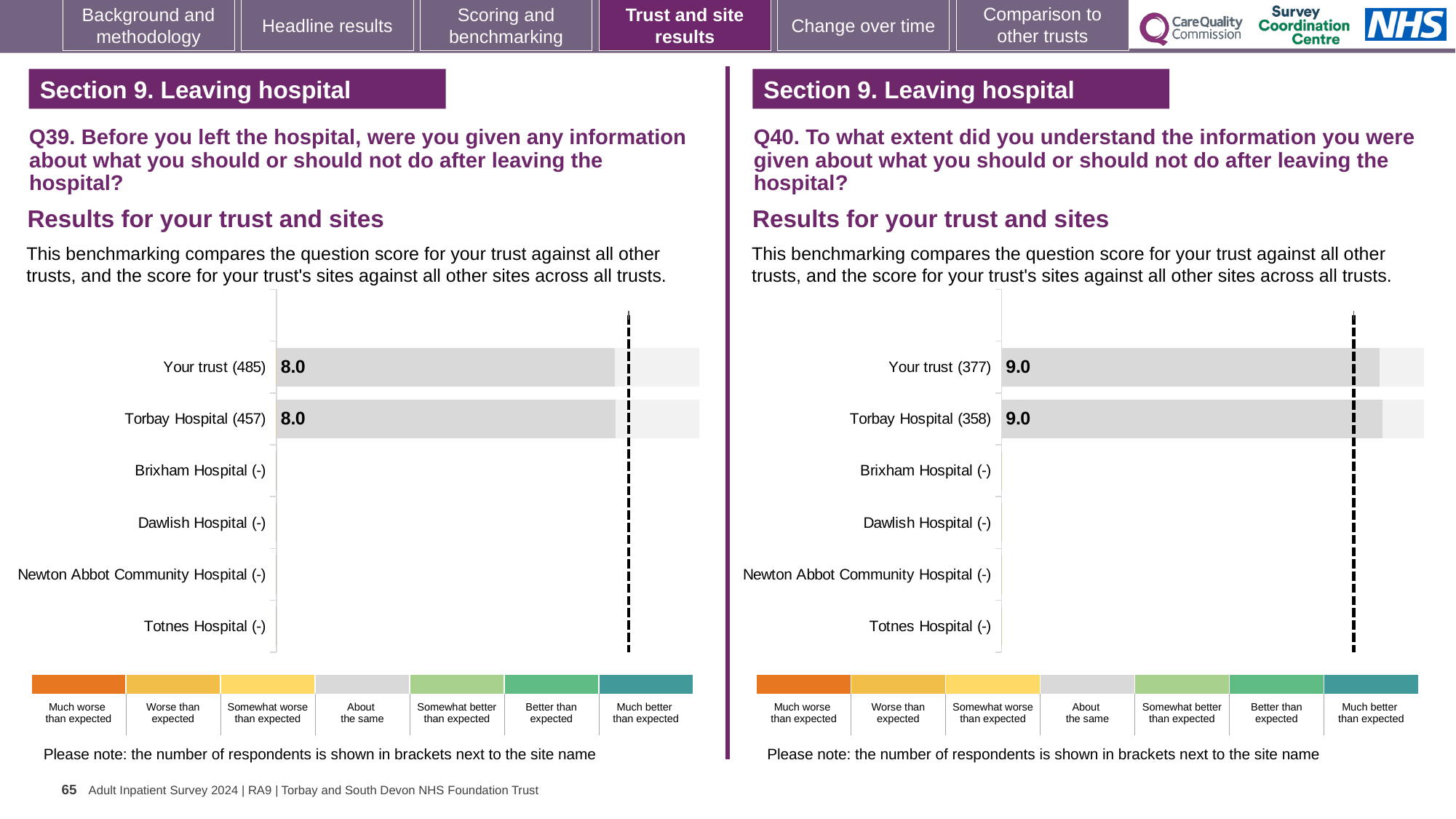
On the Q39 chart (left), what is the score for Your trust? 8.0 On the Q40 chart (right), which benchmark category does the colour of the plotted bars correspond to in the legend? About the same On the Q39 chart (left), how many respondents are shown in brackets for Your trust? 485 On the Q39 chart (left), what is the score for Torbay Hospital? 8.0 On the Q40 chart (right), how many respondents are shown in brackets for Torbay Hospital? 358 On the Q39 chart (left), what is the difference between the scores for Your trust and Torbay Hospital? 0.0 On the Q39 chart (left), how many categories have a plotted bar? 2 On the Q40 chart (right), what is the score for Your trust? 9.0 What type of chart is used on the Q39 chart (left)? Bar chart On the Q40 chart (right), what is the score for Torbay Hospital? 9.0 On the Q40 chart (right), how many site or trust categories are listed on the vertical axis? 6 On the Q39 chart (left), what is the number of respondents shown for Torbay Hospital? 457